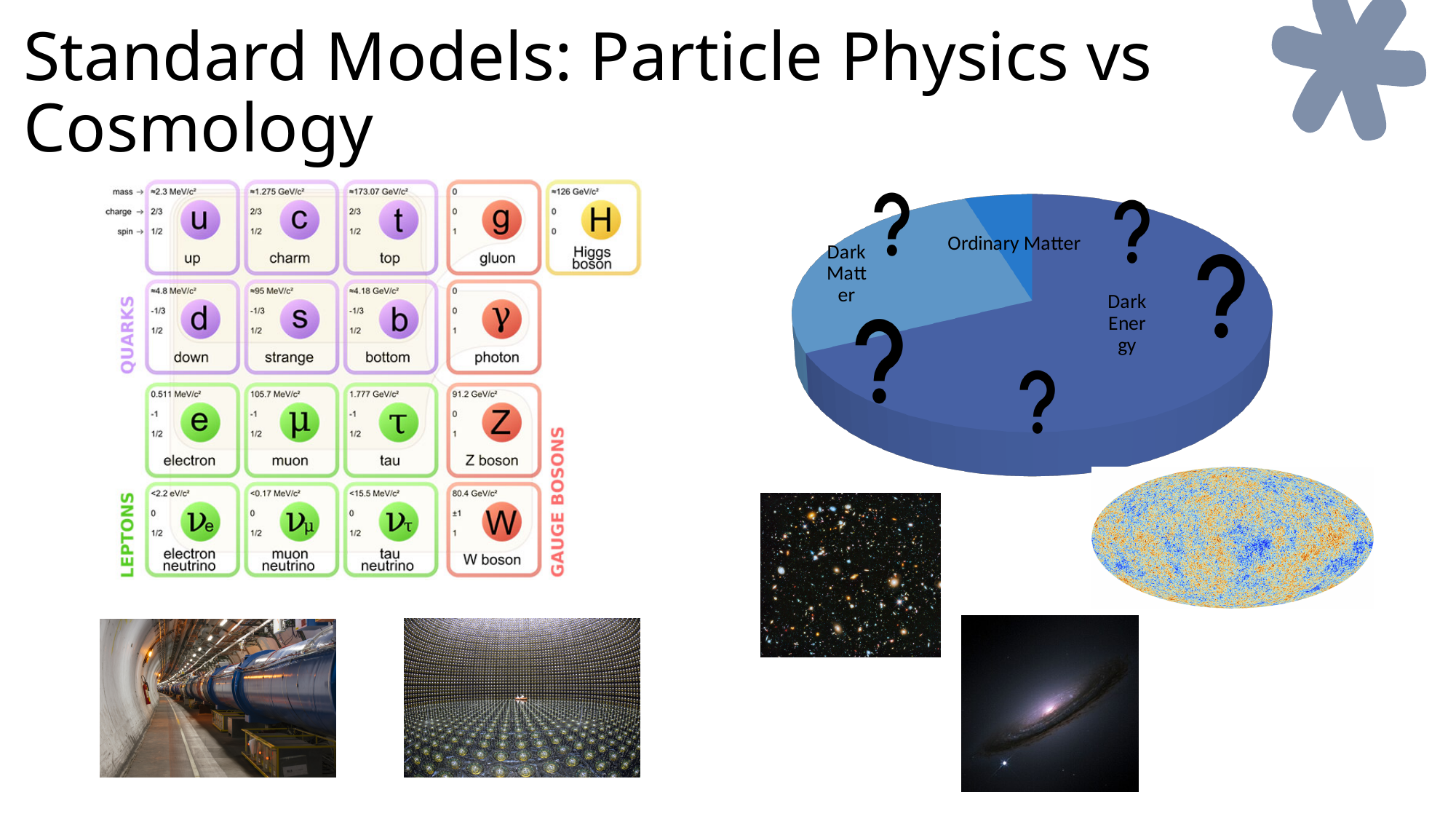
In the pie chart, which slice is larger: Dark Energy or Dark Matter? Dark Energy What kind of chart is shown on the right side of the slide? pie chart How many slices does the pie chart have? 3 What symbol is overlaid on the pie chart in place of numeric values? question marks What are the three categories labelled on the pie chart? Dark Matter, Ordinary Matter, Dark Energy In the pie chart, which slice is larger: Dark Matter or Ordinary Matter? Dark Matter Which slice of the pie chart is the smallest? Ordinary Matter Which slice of the pie chart is the largest? Dark Energy